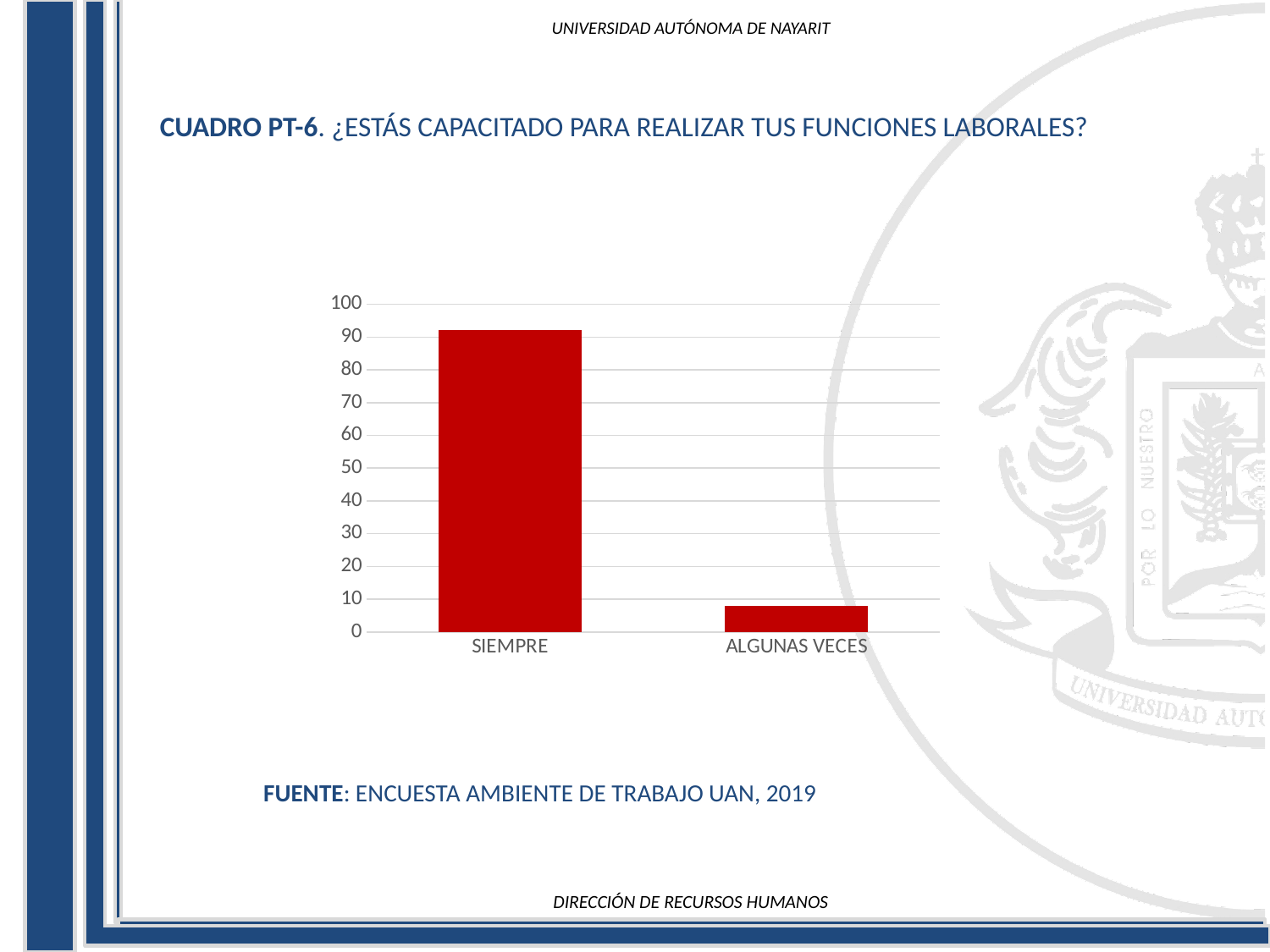
What kind of chart is shown on the slide? bar chart What is the highest value shown on the vertical axis of the chart? 100 Is the value for SIEMPRE greater or less than 80? greater What colour are the bars in the chart? red Do the values rise or fall moving from SIEMPRE to ALGUNAS VECES along the x axis? fall How many categories are shown on the x axis of the chart? 2 Is the value for SIEMPRE greater or less than 50? greater Which category has the highest value in the chart? SIEMPRE Which is larger, the value for SIEMPRE or the value for ALGUNAS VECES? SIEMPRE Is the value for ALGUNAS VECES greater or less than 10? less Which category has the lowest value in the chart? ALGUNAS VECES